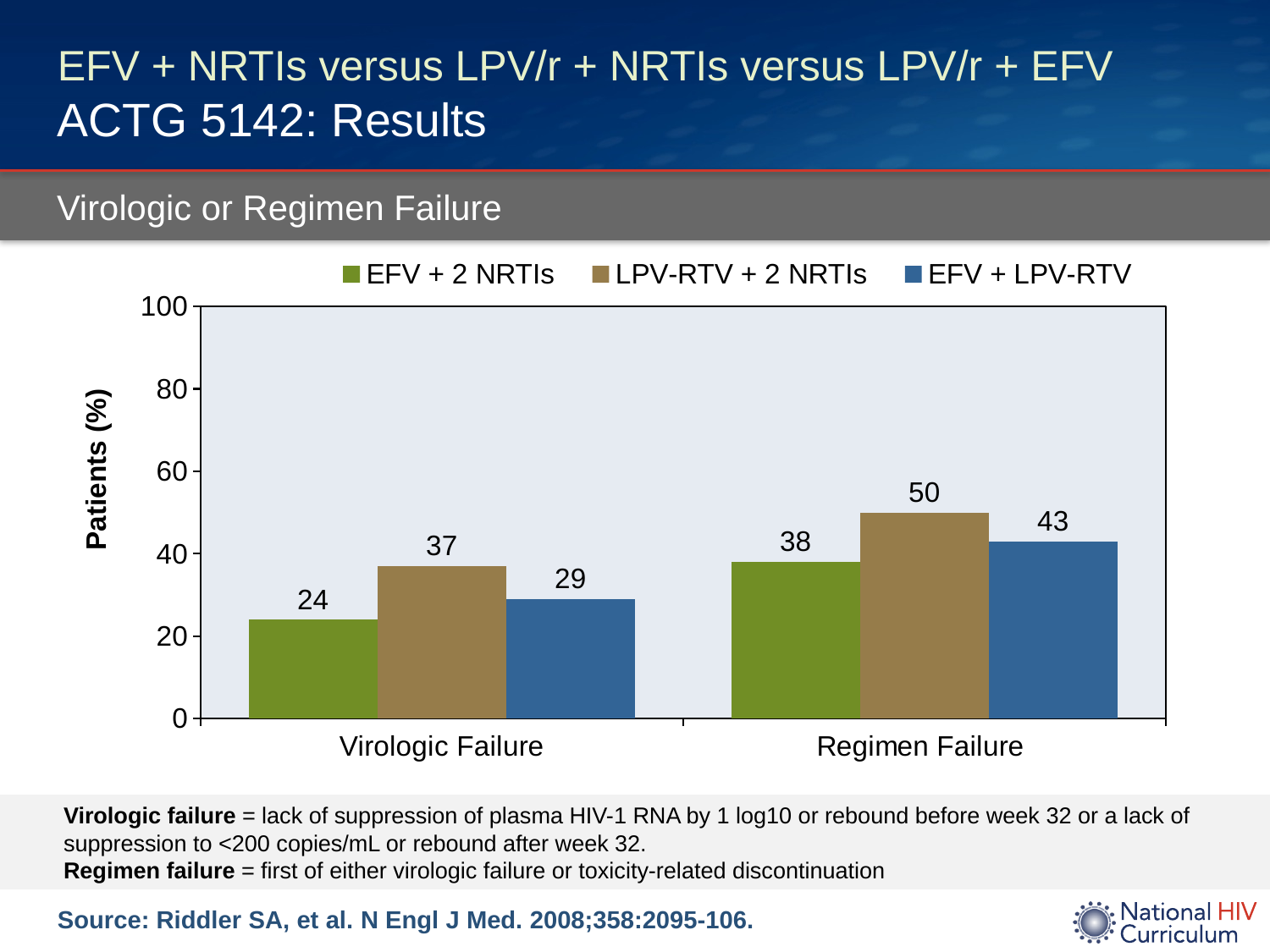
What is the value for EFV + 2 NRTIs in the Virologic Failure category? 24 What kind of chart is shown on the slide? Bar chart How many series does the legend list? 3 Which is larger: the EFV + 2 NRTIs value for Regimen Failure or the LPV-RTV + 2 NRTIs value for Virologic Failure? EFV + 2 NRTIs value for Regimen Failure What is the value for LPV-RTV + 2 NRTIs in the Regimen Failure category? 50 What is the value for EFV + LPV-RTV in the Virologic Failure category? 29 Which series has the highest value in the Regimen Failure category? LPV-RTV + 2 NRTIs What is the difference between the LPV-RTV + 2 NRTIs and EFV + 2 NRTIs values in the Virologic Failure category? 13 Is the value for EFV + LPV-RTV in the Regimen Failure category greater or less than 40? greater What is the difference between the Regimen Failure and Virologic Failure values for EFV + LPV-RTV? 14 How many categories are shown on the x axis? 2 Which series has the lowest value in the Virologic Failure category? EFV + 2 NRTIs